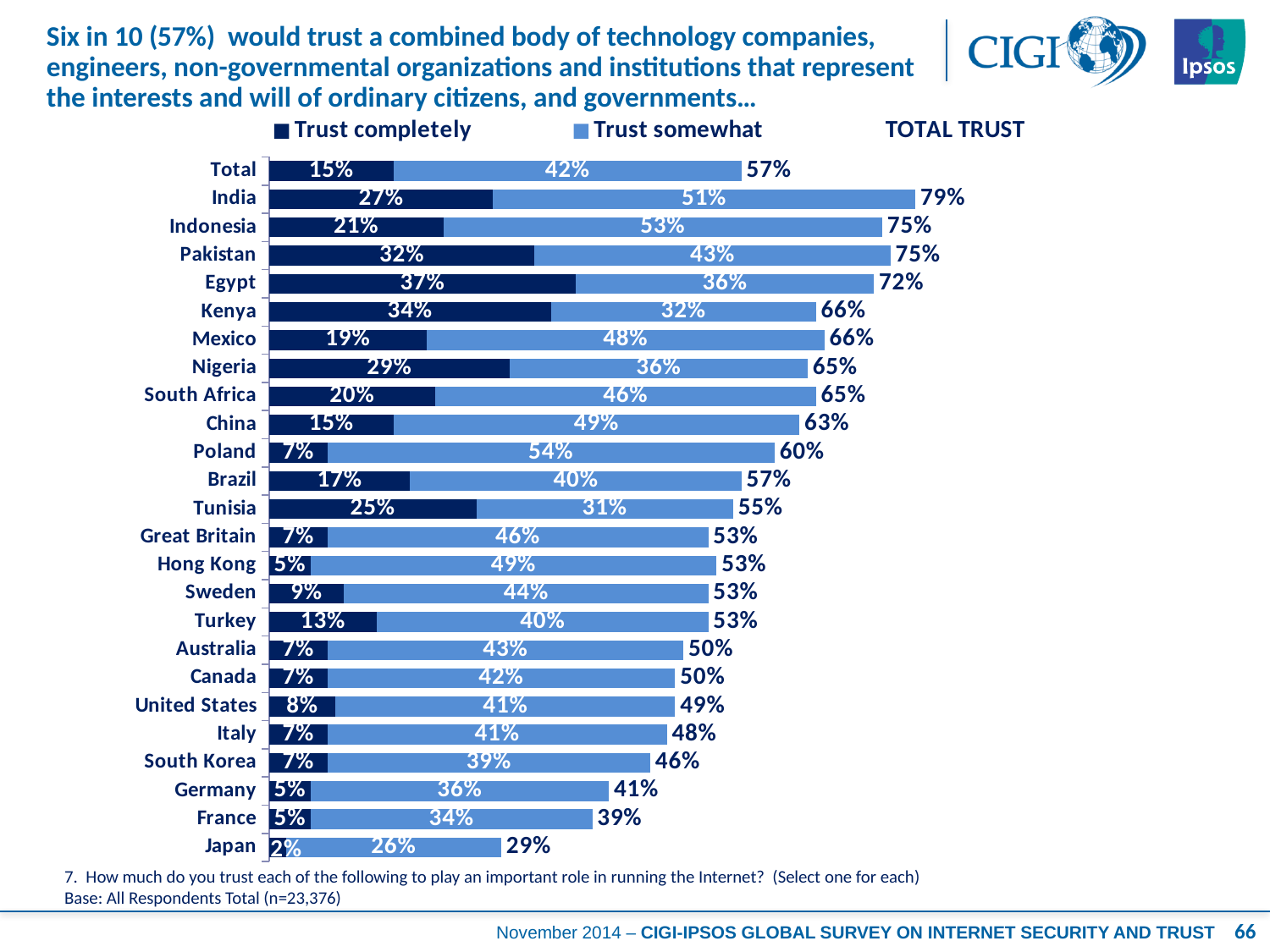
What is the difference between the total trust for India and the total trust for Japan? 50% How many series does the legend list? 2 What is the 'Trust somewhat' value for Poland? 54% Which country has the highest 'Trust completely' value? Egypt Which country has the highest total trust? India What percentage of respondents in India trust completely? 27% What are the two legend entries of the chart? Trust completely; Trust somewhat Which is larger, the 'Trust completely' value for Pakistan or for Nigeria? Pakistan What is the total trust value for Egypt? 72% Which country has the lowest total trust? Japan What is the total of the stacked bar for Kenya? 66% What kind of chart is shown on the slide? Stacked bar chart